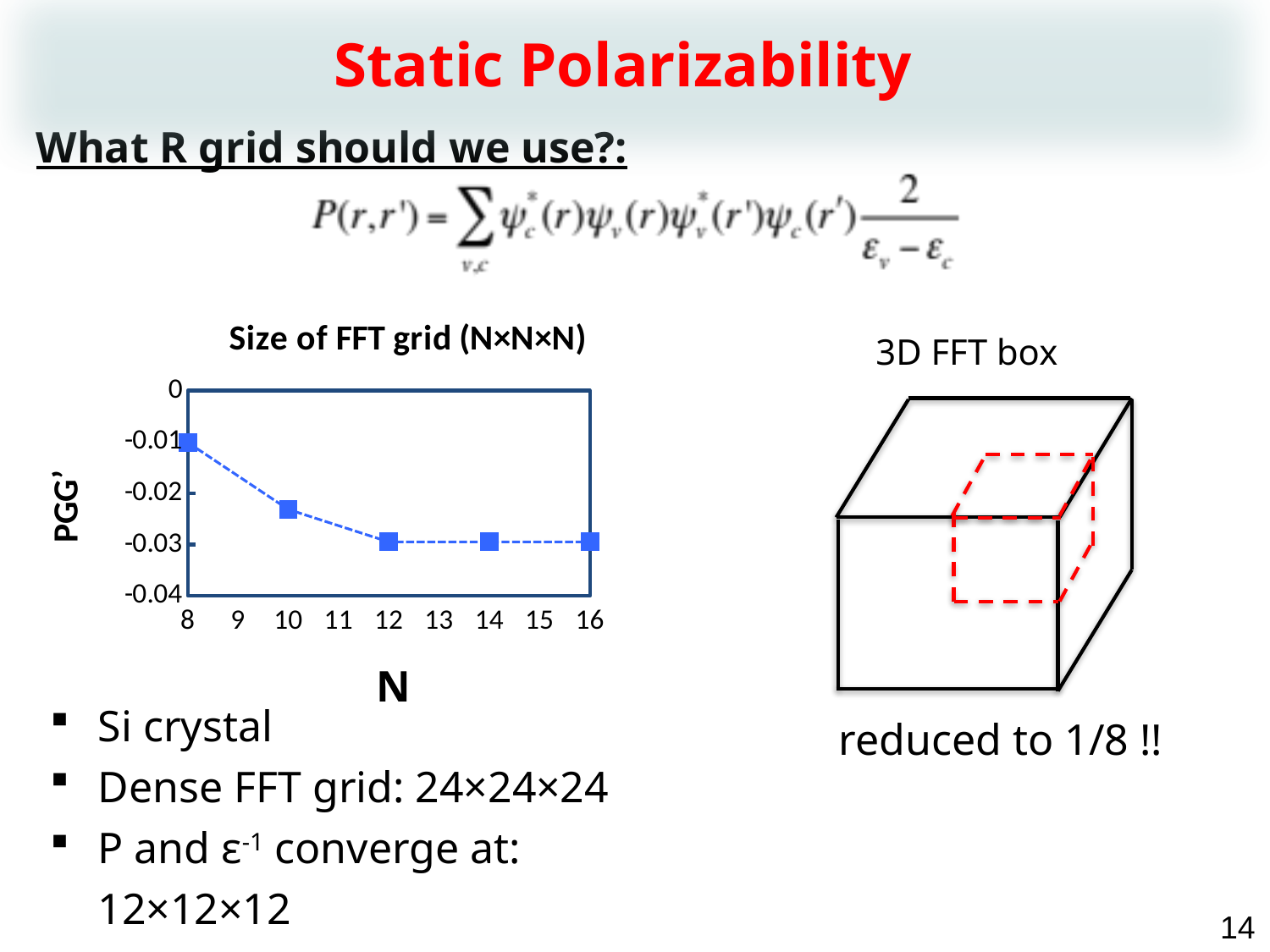
In the "Size of FFT grid (N×N×N)" chart, is the value of PGG' at N=12 greater or less than -0.04? greater What kind of chart is shown under the title "Size of FFT grid (N×N×N)"? line chart In the "Size of FFT grid (N×N×N)" chart, is the value of PGG' at N=8 greater or less than -0.02? greater In the "Size of FFT grid (N×N×N)" chart, do the PGG' values rise or fall as N increases from 8 to 12? fall In the "Size of FFT grid (N×N×N)" chart, which has the larger PGG' value: N=10 or N=12? N=10 What is the label of the x axis in the "Size of FFT grid (N×N×N)" chart? N In the "Size of FFT grid (N×N×N)" chart, is the value of PGG' at N=16 greater or less than -0.02? less What is the label of the y axis in the "Size of FFT grid (N×N×N)" chart? PGG' In the "Size of FFT grid (N×N×N)" chart, which has the larger PGG' value: N=8 or N=10? N=8 How many data points are plotted in the "Size of FFT grid (N×N×N)" chart? 5 In the "Size of FFT grid (N×N×N)" chart, at which value of N is PGG' highest? 8